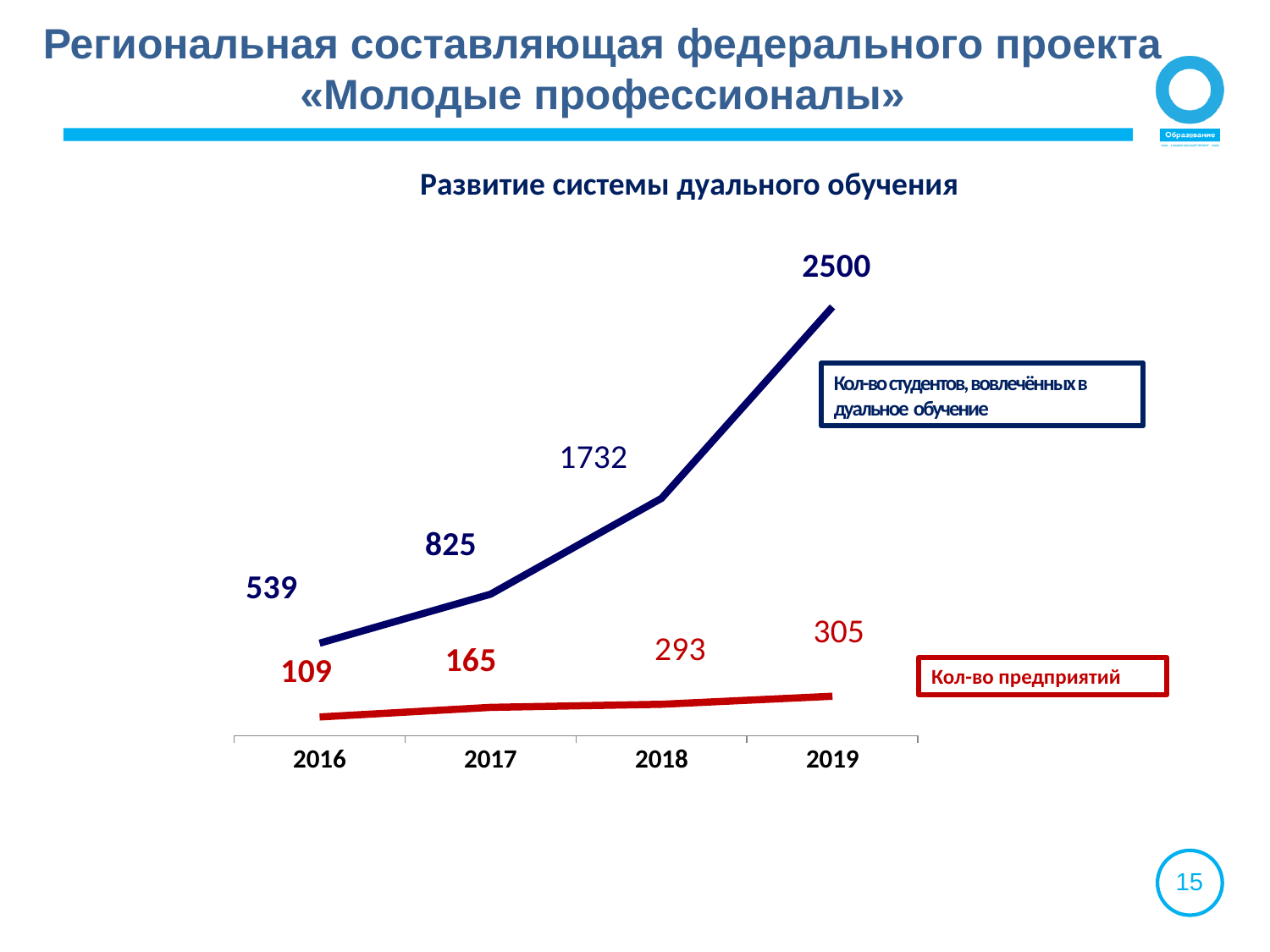
By how much did the number of students involved in dual education increase from 2018 to 2019? 768 What is the difference between the number of enterprises in 2019 and in 2018? 12 What is the number of enterprises in 2016? 109 What kind of chart is shown on the slide? line chart Which is larger: the number of students in 2017 or the number of students in 2016? 2017 In which year is the number of students involved in dual education the lowest? 2016 What is the number of students involved in dual education in 2018? 1732 What is the number of students involved in dual education (Кол-во студентов, вовлечённых в дуальное обучение) in 2019? 2500 Does the number of students involved in dual education rise or fall from 2016 to 2019? rise What is the number of enterprises (Кол-во предприятий) in 2017? 165 In which year is the number of enterprises the highest? 2019 How many years are shown on the x axis? 4